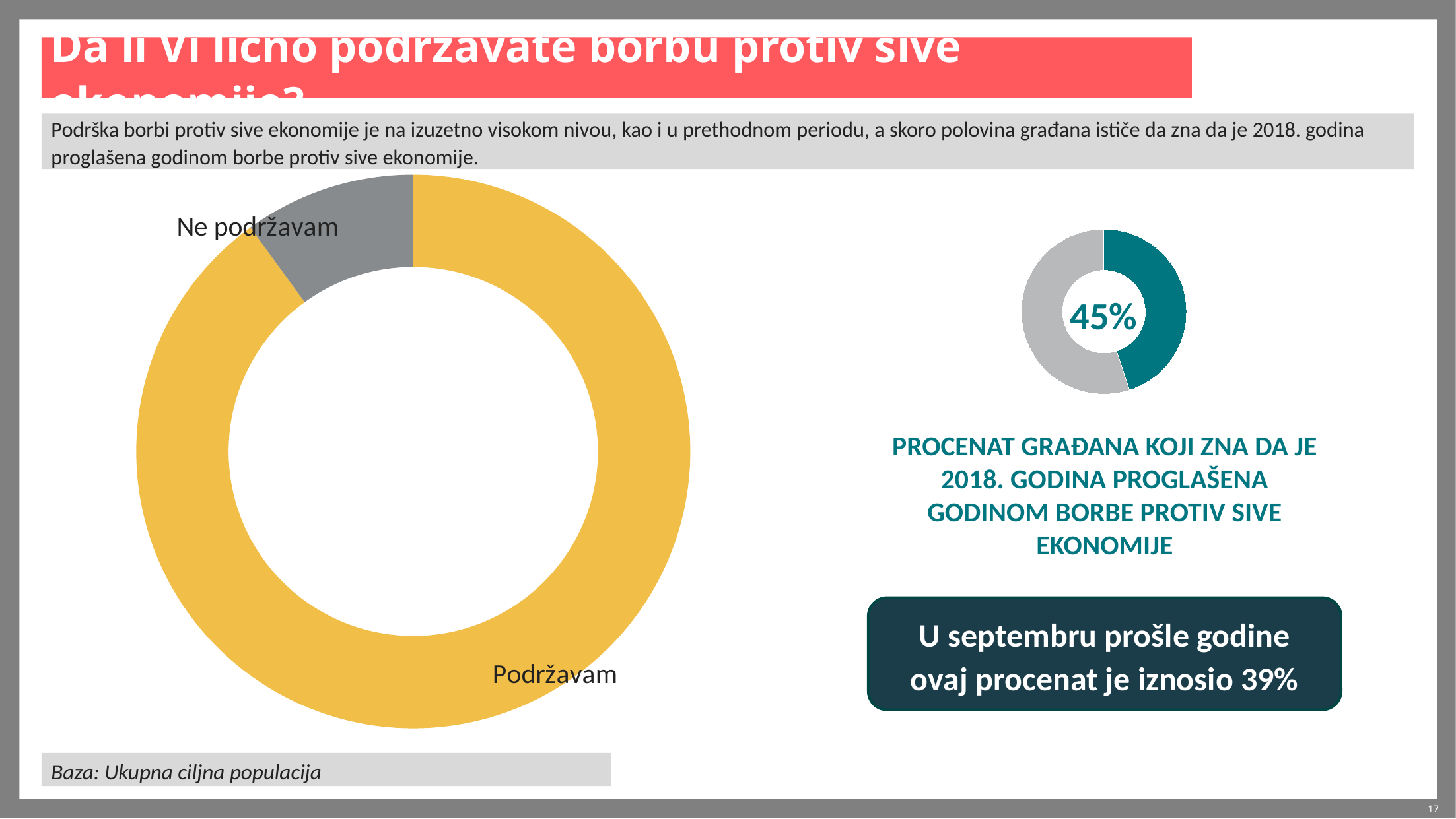
In the large donut chart on the left, what colour is the Podržavam segment? Yellow How many charts are shown on the slide? 2 In the large donut chart on the left, which category has the smallest share? Ne podržavam In the large donut chart on the left, what colour is the Ne podržavam segment? Grey What kind of chart is the small chart on the right of the slide? Donut chart In the large donut chart on the left, which category has the largest share? Podržavam In the large donut chart on the left, which is larger: Podržavam or Ne podržavam? Podržavam What kind of chart is the large chart on the left of the slide? Donut chart How many categories does the large donut chart on the left show? 2 In the small donut chart on the right, what percentage is printed in the centre? 45% In the small donut chart on the right, which segment is larger: the teal segment or the grey segment? The grey segment In the small donut chart on the right, what share of citizens know that 2018 was declared the year of the fight against the grey economy? 45%